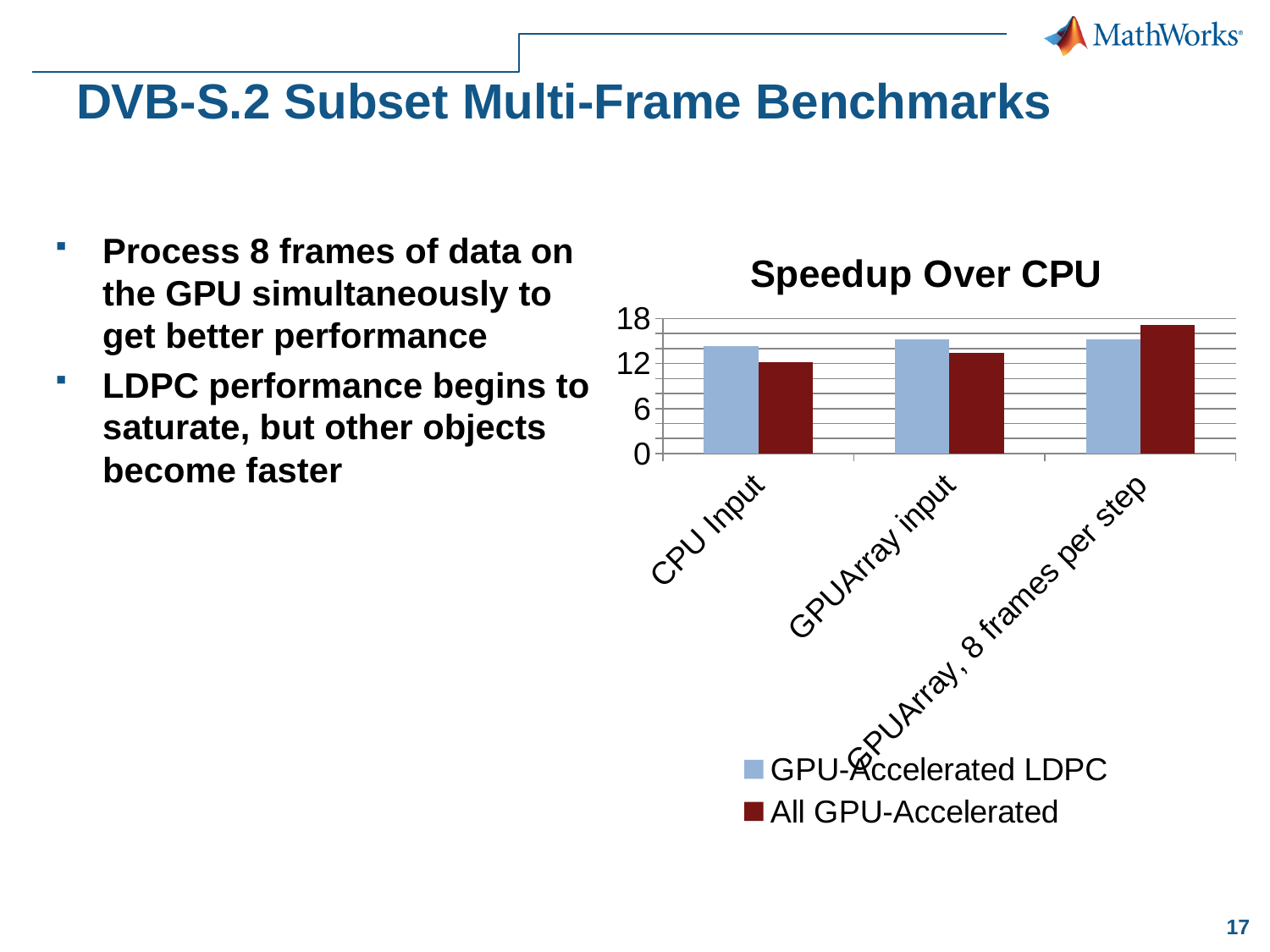
Which series is shown in dark red in the chart? All GPU-Accelerated How many categories are shown on the x axis of the chart? 3 Is the GPU-Accelerated LDPC speedup for CPU Input greater or less than 12? greater Is the All GPU-Accelerated speedup for GPUArray, 8 frames per step greater or less than 18? less Does the All GPU-Accelerated speedup rise or fall from CPU Input to GPUArray, 8 frames per step? rise How many series does the chart legend list? 2 For CPU Input, which series has the larger speedup: GPU-Accelerated LDPC or All GPU-Accelerated? GPU-Accelerated LDPC For which category is the All GPU-Accelerated speedup lowest? CPU Input What is the title of the chart? Speedup Over CPU For which category is the All GPU-Accelerated speedup highest? GPUArray, 8 frames per step For GPUArray, 8 frames per step, which series has the larger speedup: GPU-Accelerated LDPC or All GPU-Accelerated? All GPU-Accelerated What type of chart is shown on the slide? bar chart